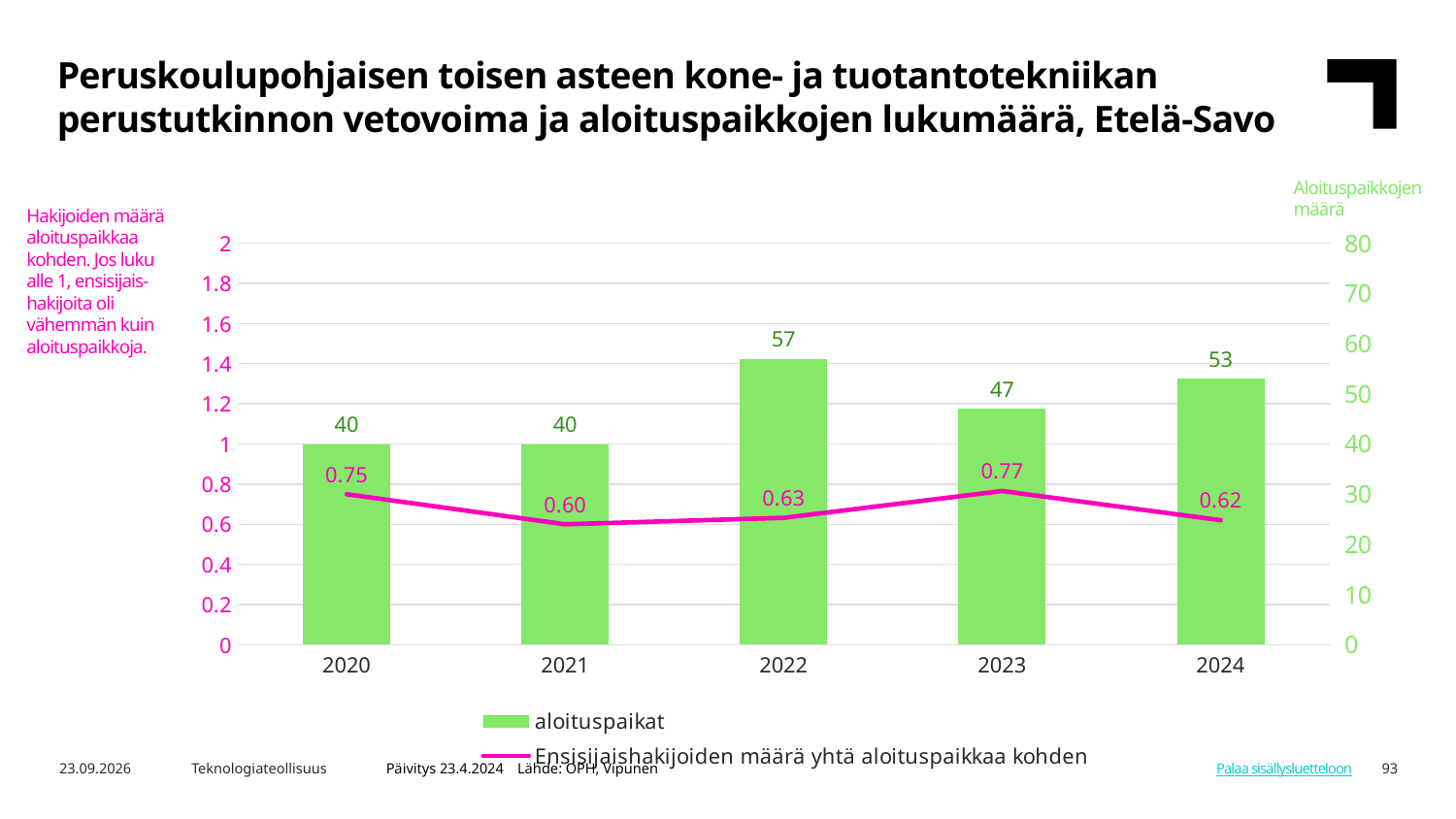
In which year is Ensisijaishakijoiden määrä yhtä aloituspaikkaa kohden lowest? 2021 Which year has a larger value of aloituspaikat, 2023 or 2024? 2024 How many years are shown on the x axis? 5 What is the value of aloituspaikat in 2022? 57 What colour are the aloituspaikat bars? green How many series does the legend list? 2 What kind of chart is used for the aloituspaikat series? bar chart What is the value of Ensisijaishakijoiden määrä yhtä aloituspaikkaa kohden in 2023? 0.77 What is the value of aloituspaikat in 2024? 53 Does the value of aloituspaikat rise or fall from 2021 to 2022? rise What is the difference in aloituspaikat between 2022 and 2021? 17 In which year is aloituspaikat highest? 2022